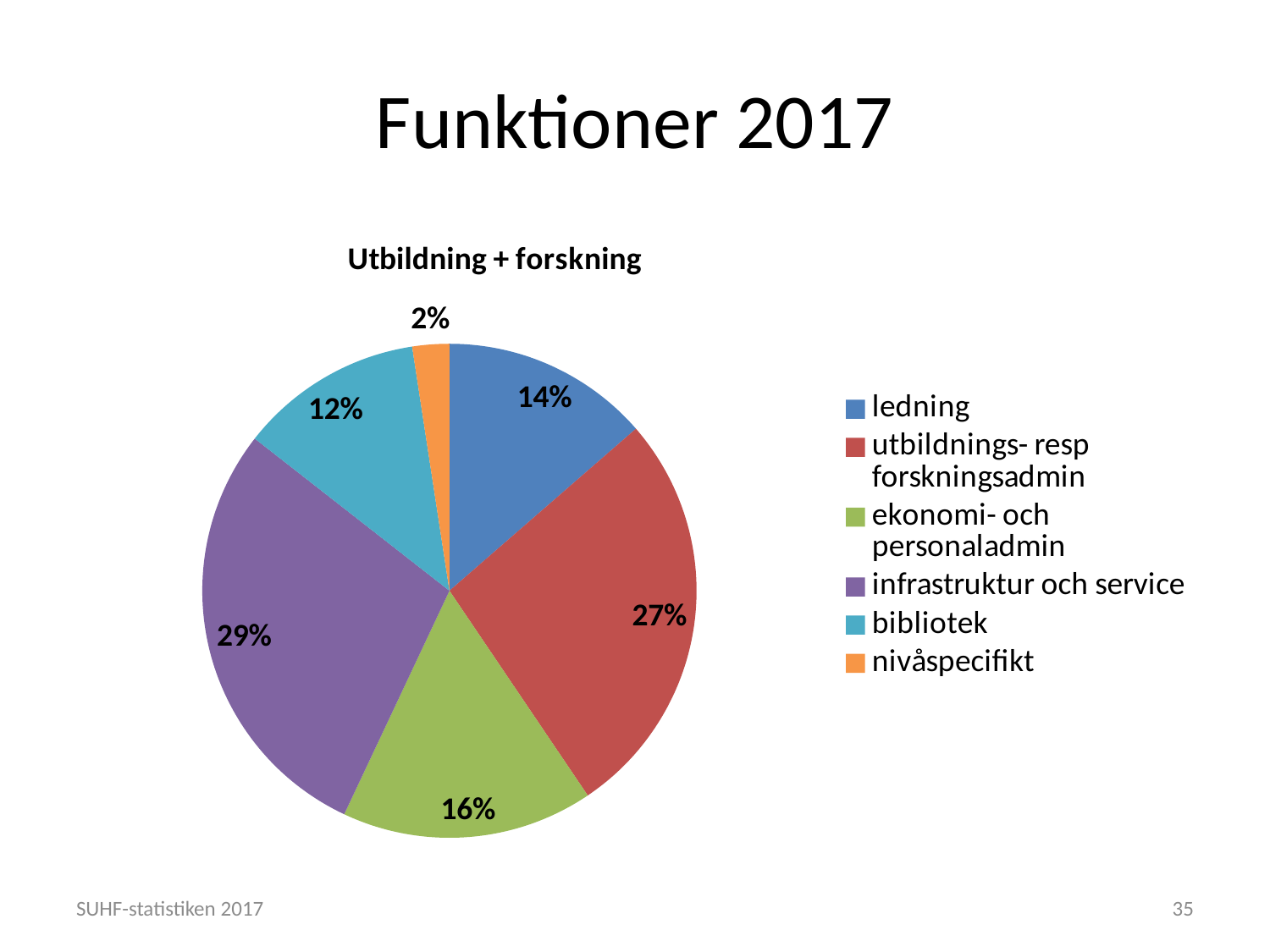
What share of the pie does utbildnings- resp forskningsadmin have? 27% What share of the pie does ekonomi- och personaladmin have? 16% What share of the pie does ledning have? 14% How many categories does the legend list? 6 What kind of chart is shown on the slide? pie chart What is the chart's title? Utbildning + forskning Which category has the largest share of the pie? infrastruktur och service Which category has the smallest share of the pie? nivåspecifikt What is the difference in percentage points between utbildnings- resp forskningsadmin and ledning? 13